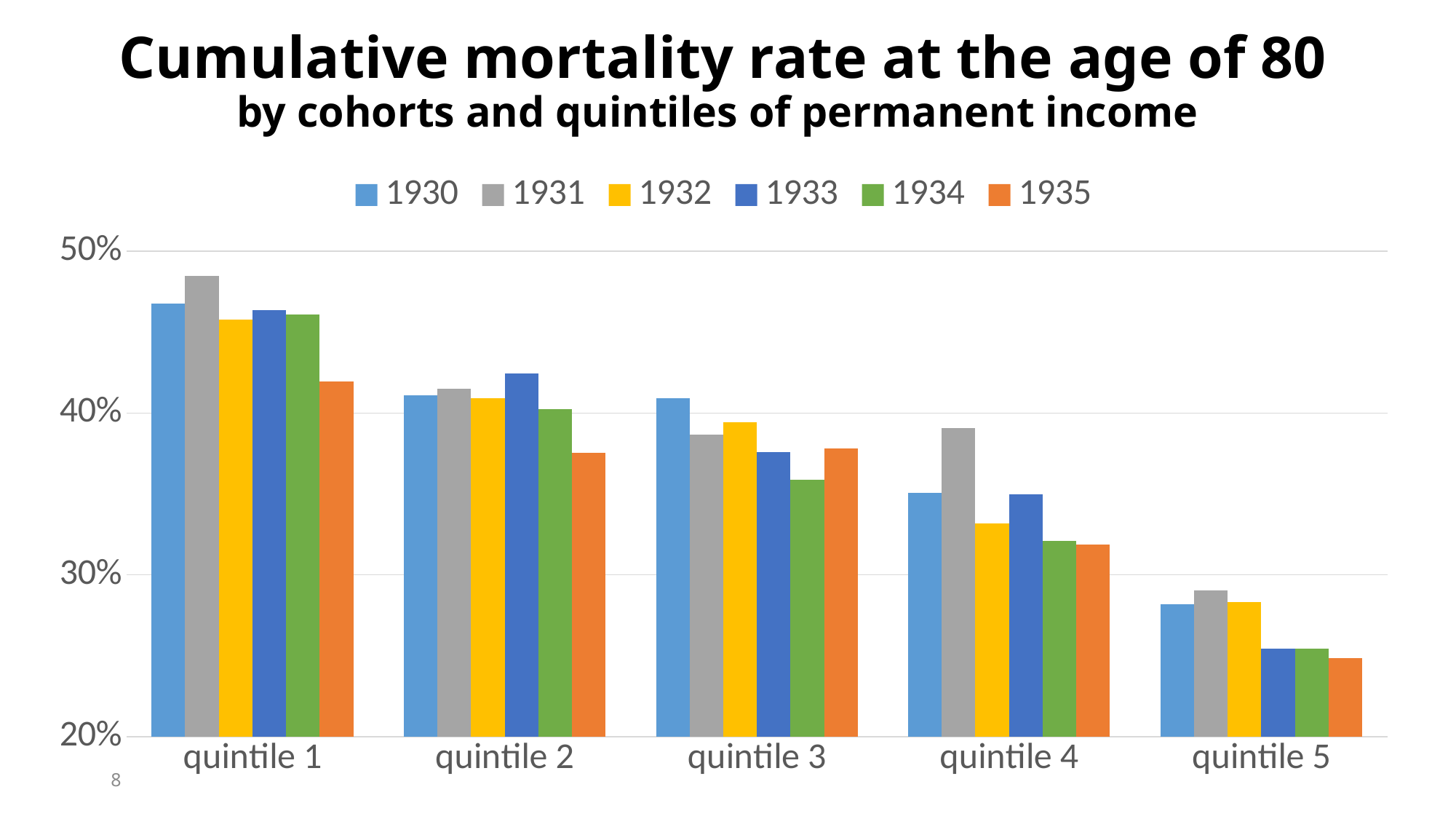
In quintile 4, which is larger: the value for the 1930 cohort or the 1931 cohort? 1931 Do the values for the 1930 cohort rise or fall from quintile 1 to quintile 5? fall Within quintile 1, which cohort has the highest cumulative mortality rate? 1931 Is the value for the 1933 cohort in quintile 2 greater or less than 40%? greater How many quintile categories are shown on the x axis? 5 Within quintile 2, which cohort has the highest cumulative mortality rate? 1933 How many series does the legend list? 6 Is the value for the 1935 cohort in quintile 1 greater or less than 40%? greater What kind of chart is shown on the slide? bar chart Is the value for the 1935 cohort in quintile 5 greater or less than 30%? less Within quintile 1, which cohort has the lowest cumulative mortality rate? 1935 What is the title of the chart? Cumulative mortality rate at the age of 80 by cohorts and quintiles of permanent income